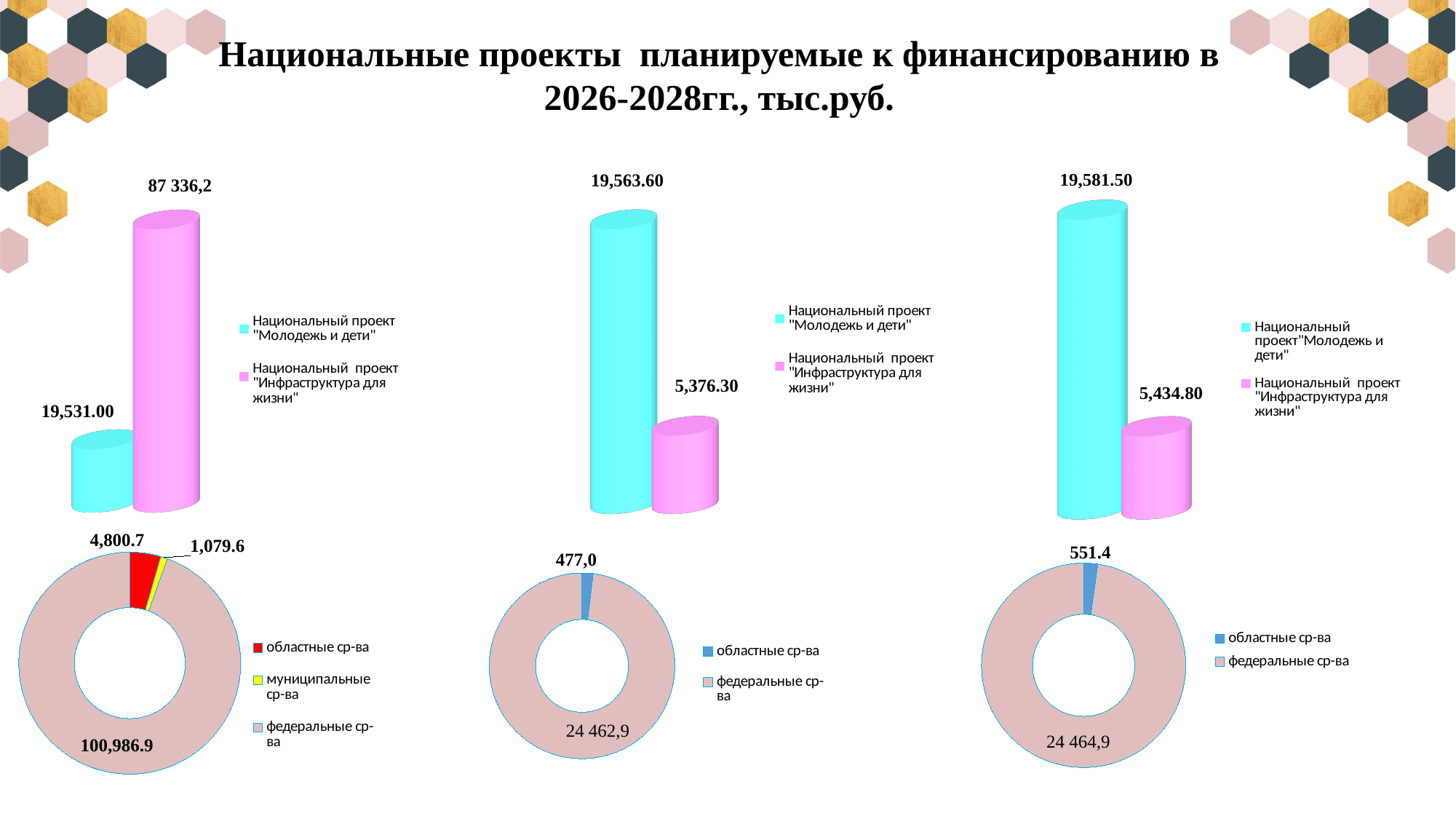
In the top-middle bar chart, what is the value for Национальный проект "Инфраструктура для жизни"? 5,376.30 How many categories does the legend of the bottom-left doughnut chart list? 3 In the top-right bar chart, what is the value for Национальный проект "Молодежь и дети"? 19,581.50 In the top-left bar chart, what is the value for Национальный проект "Инфраструктура для жизни"? 87 336,2 In the bottom-right doughnut chart, what is the value for федеральные ср-ва? 24 464,9 In the bottom-left doughnut chart, what is the value for муниципальные ср-ва? 1,079.6 In the bottom-left doughnut chart, which category has the largest value? федеральные ср-ва In the top-left bar chart, which series has the larger value: "Молодежь и дети" or "Инфраструктура для жизни"? Национальный проект "Инфраструктура для жизни" In the top-right bar chart, which series has the higher value? Национальный проект "Молодежь и дети" In the top-left bar chart, what is the value for Национальный проект "Молодежь и дети"? 19,531.00 What kind of chart is shown in the bottom-left of the slide? Doughnut chart In the bottom-middle doughnut chart, what is the value for областные ср-ва? 477,0